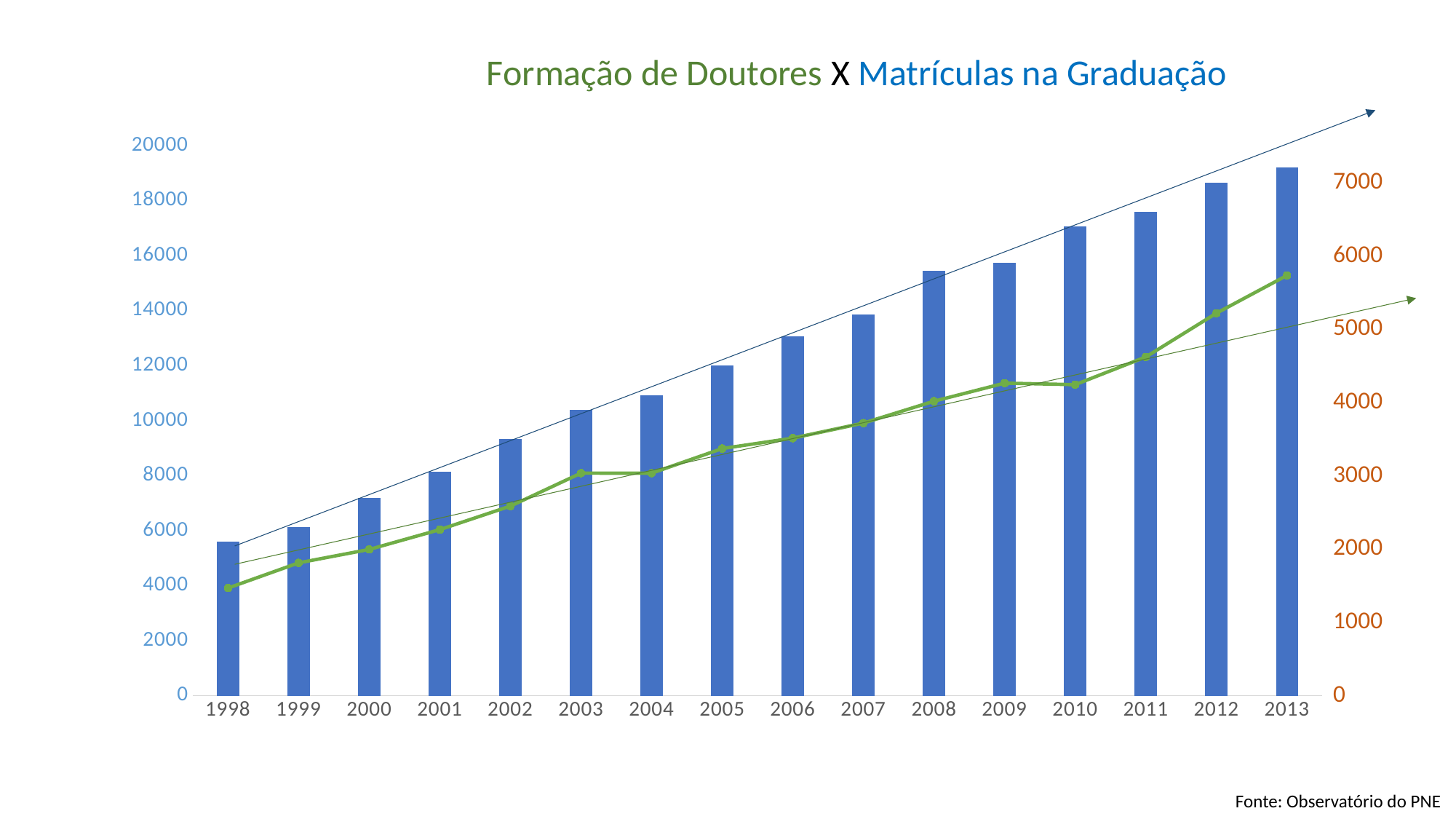
Is the green line value (Formação de Doutores) for 2013 greater or less than 5000 on the right axis? greater Is the blue bar for 2008 greater or less than 14000 on the left axis? greater How many years are shown on the x axis of the chart? 16 Which year has the tallest blue bar (Matrículas na Graduação)? 2013 Is the blue bar for 2013 greater or less than 18000 on the left axis? greater What is the source cited at the bottom of the slide? Fonte: Observatório do PNE Do the blue bars (Matrículas na Graduação) rise or fall from 1998 to 2013? Rise Which year has the taller blue bar, 2011 or 2012? 2012 What kind of chart is shown on the slide? A combined bar and line chart Which year has the shortest blue bar (Matrículas na Graduação)? 1998